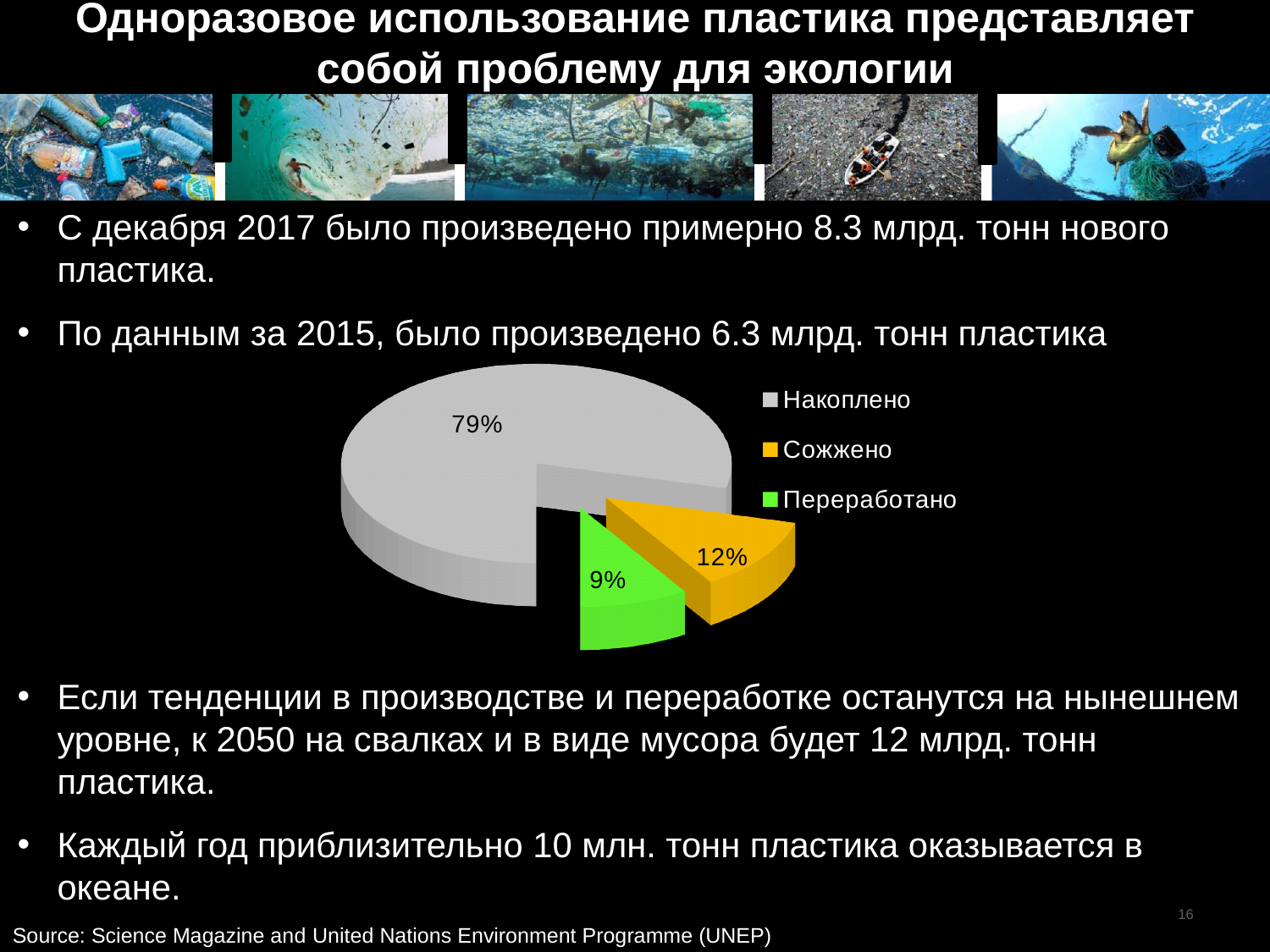
How many slices does the pie chart have? 3 What share of the pie is labelled Накоплено? 79% What share of the pie is labelled Переработано? 9% What colour is the slice for Переработано? green What kind of chart is shown on the slide? pie chart Which is larger, the share for Сожжено or the share for Переработано? Сожжено How many entries does the legend list? 3 Which category has the largest slice of the pie? Накоплено What share of the pie is labelled Сожжено? 12% What is the difference in percentage points between Накоплено and Сожжено? 67 What is the difference in percentage points between Сожжено and Переработано? 3 Which category has the smallest slice of the pie? Переработано